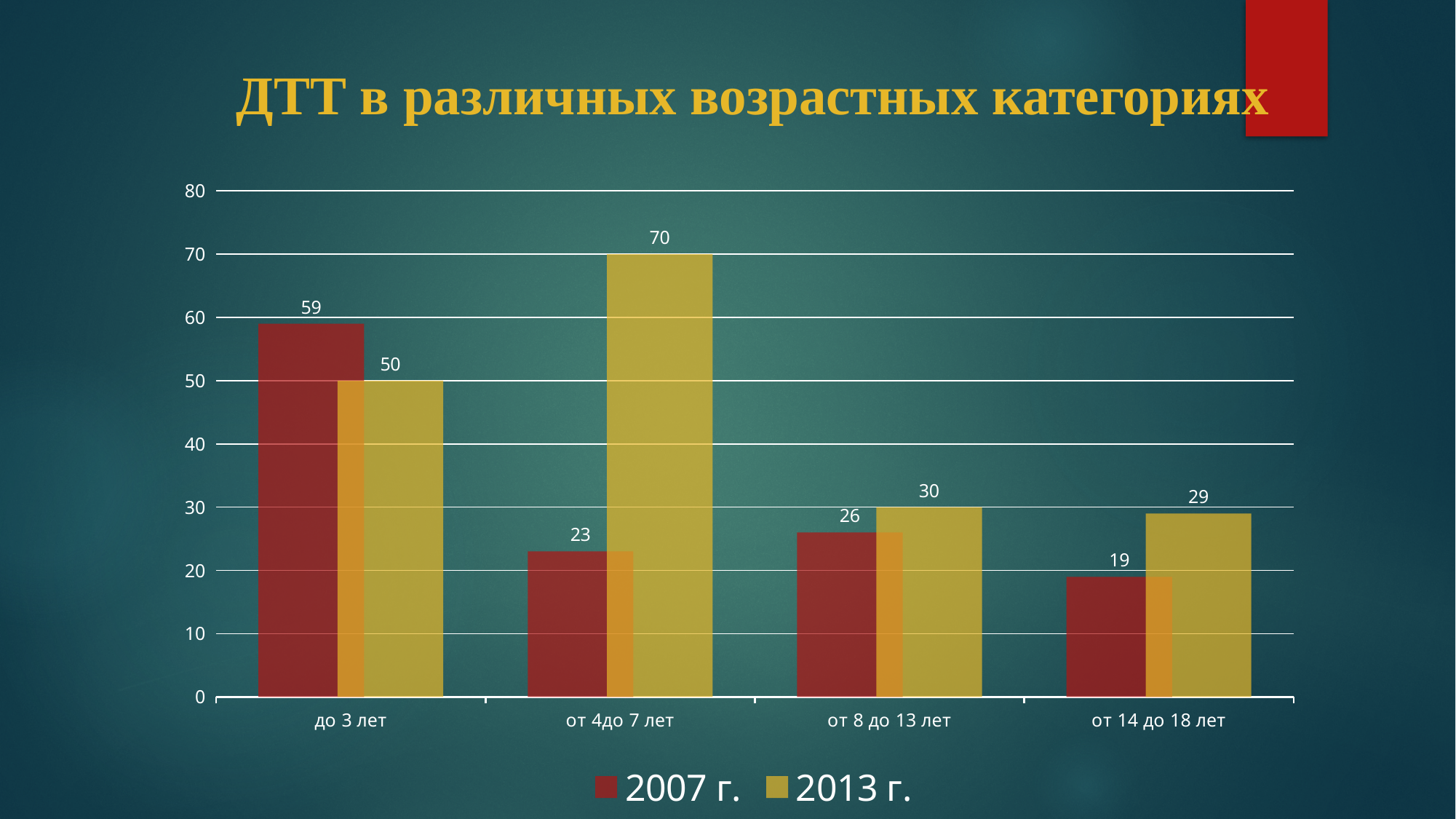
What is the title of the chart? ДТТ в различных возрастных категориях What is the value for 2013 г. in the category от 4до 7 лет? 70 What is the value for 2007 г. in the category от 14 до 18 лет? 19 What kind of chart is shown on the slide? bar chart How many series does the legend list? 2 What is the value for 2007 г. in the category до 3 лет? 59 What is the value for 2013 г. in the category от 8 до 13 лет? 30 What is the difference between the 2013 г. and 2007 г. values in the category от 4до 7 лет? 47 Which category has the lowest value for 2007 г.? от 14 до 18 лет Which is larger in the category до 3 лет: the value for 2007 г. or for 2013 г.? 2007 г. Which category has the highest value for 2013 г.? от 4до 7 лет How many age categories are shown on the x axis? 4